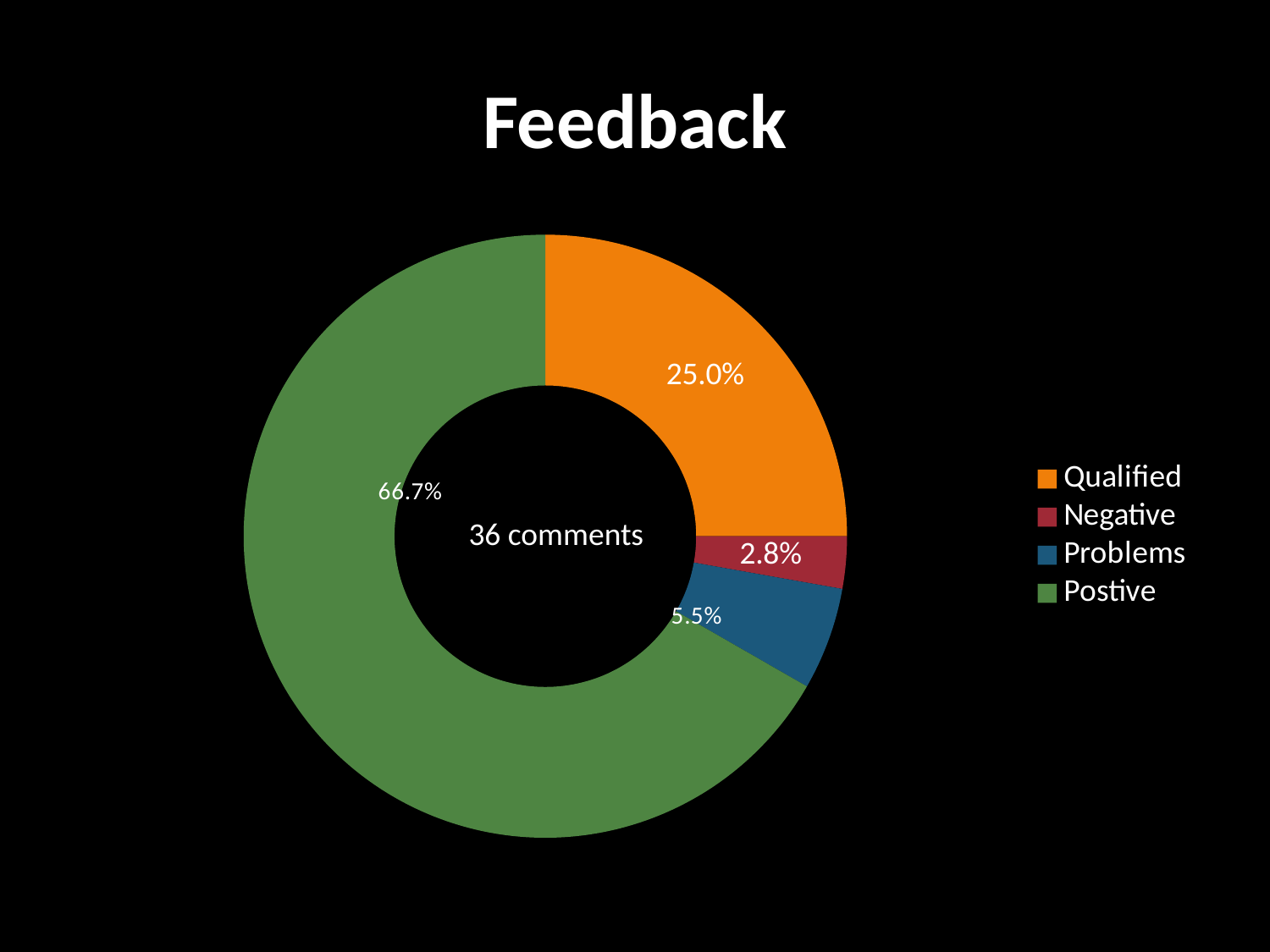
What share of the Feedback chart is labelled Postive? 66.7% What share of the Feedback chart is labelled Negative? 2.8% Which is larger in the Feedback chart, the Problems share or the Negative share? Problems Which category has the smallest share in the Feedback chart? Negative What is the difference in percentage points between the Postive and Qualified shares? 41.7 Which category has the largest share in the Feedback chart? Postive What share of the Feedback chart is labelled Problems? 5.5% What kind of chart is shown on the slide? Doughnut (pie) chart How many categories does the Feedback chart show? 4 What colour represents Qualified in the Feedback chart? Orange What text appears in the centre of the Feedback chart? 36 comments What share of the Feedback chart is labelled Qualified? 25.0%